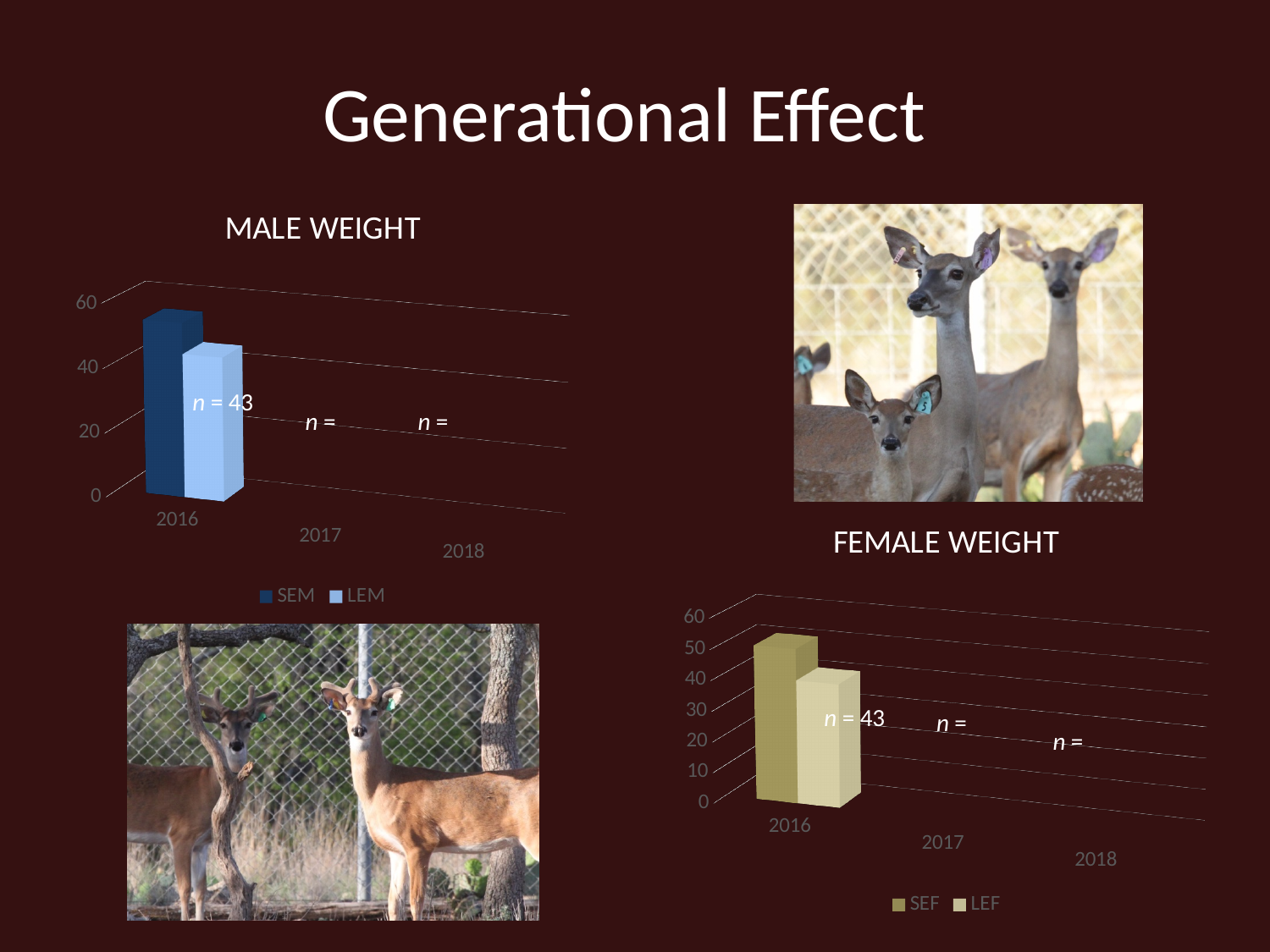
How many year categories are shown on the x axis of the FEMALE WEIGHT chart? 3 What kind of chart is the FEMALE WEIGHT chart? bar chart How many year categories are shown on the x axis of the MALE WEIGHT chart? 3 What are the two legend entries of the FEMALE WEIGHT chart? SEF and LEF In the FEMALE WEIGHT chart, is the LEF value for 2016 greater or less than 30? greater What kind of chart is the MALE WEIGHT chart? bar chart In the FEMALE WEIGHT chart, which series has the larger value for 2016, SEF or LEF? SEF In the MALE WEIGHT chart, which series has the larger value for 2016, SEM or LEM? SEM How many series does the legend of the FEMALE WEIGHT chart list? 2 How many series does the legend of the MALE WEIGHT chart list? 2 In the FEMALE WEIGHT chart, is the SEF value for 2016 greater or less than 40? greater In the MALE WEIGHT chart, is the SEM value for 2016 greater or less than 40? greater